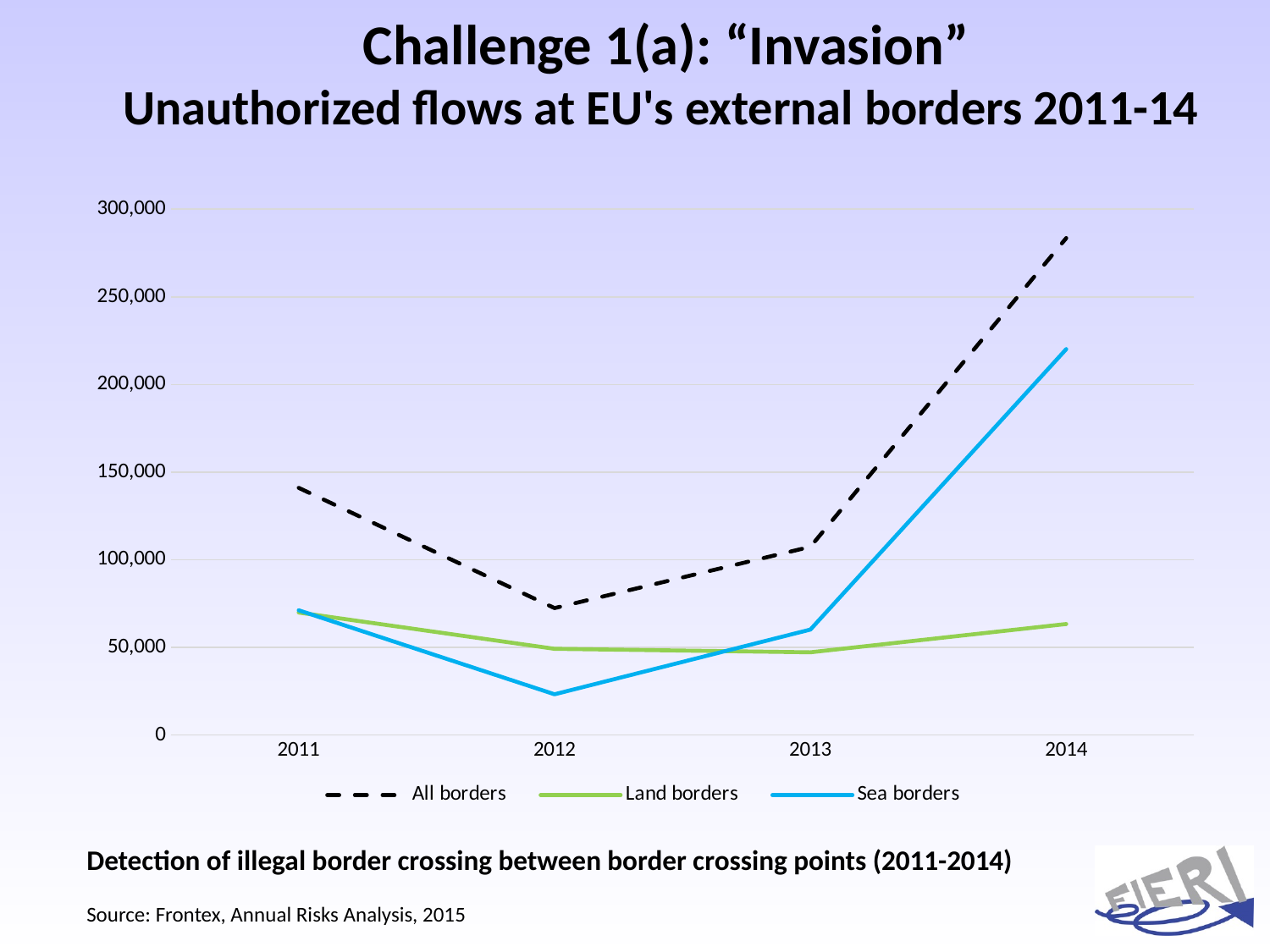
Does the All borders series rise or fall from 2012 to 2014? Rise In 2014, which is larger: Sea borders or Land borders? Sea borders Which series is drawn with a dashed line? All borders How many series does the legend list? 3 Is the value for Sea borders in 2012 greater or less than 50,000? less Is the value for Land borders in 2011 greater or less than 50,000? greater Is the value for All borders in 2011 greater or less than 150,000? less How many years are plotted along the x axis? 4 In which year is the Sea borders series at its lowest? 2012 What kind of chart is shown on the slide? Line chart In which year is the All borders series at its highest? 2014